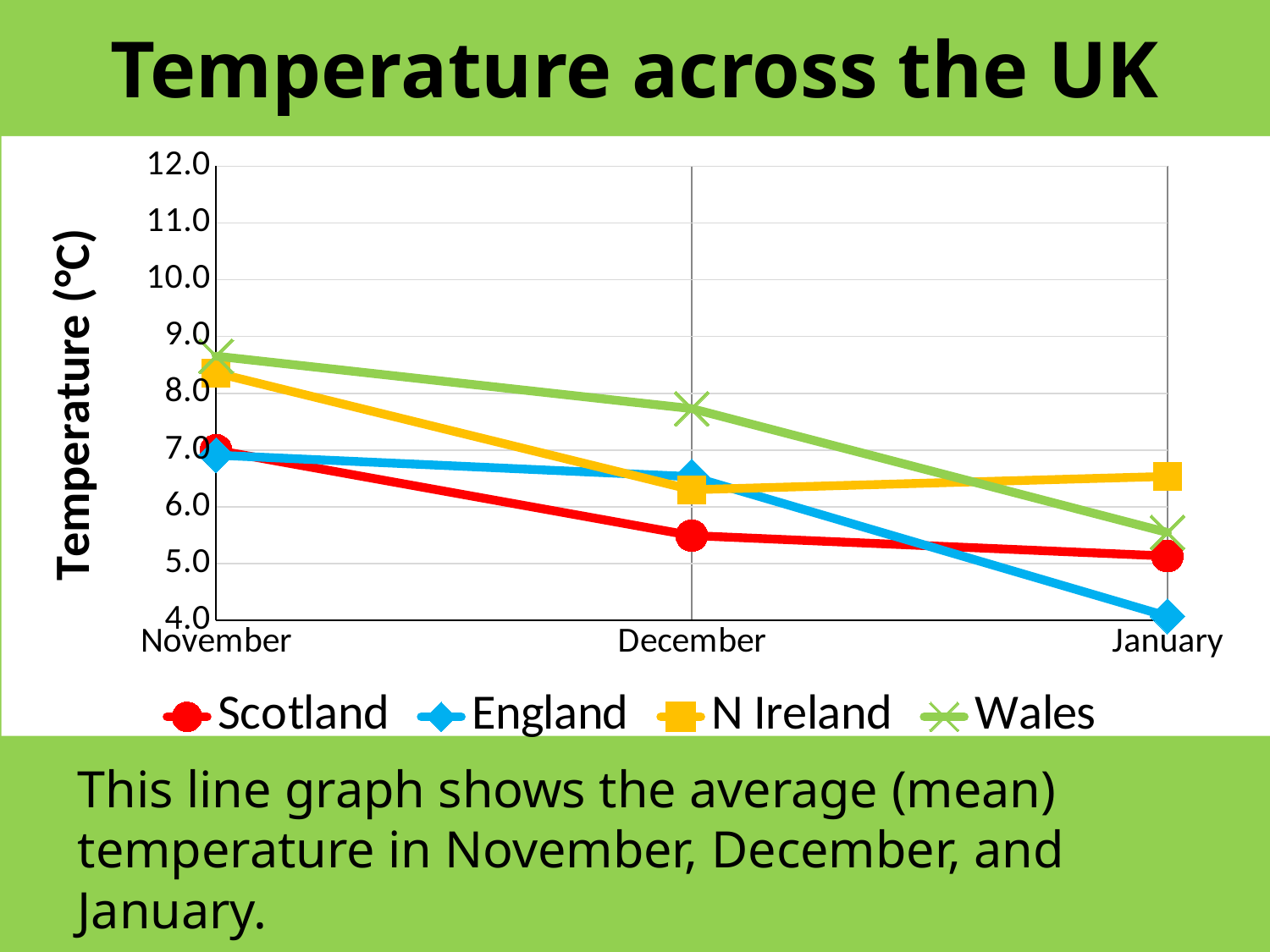
Which country has the highest temperature in January? N Ireland Is the temperature for N Ireland in November greater or less than 8.0? greater Is the temperature for Wales in December greater or less than 7.0? greater Which country has the lowest temperature in January? England How many series does the legend list? 4 Does the temperature for Scotland rise or fall from November to January? fall Which country has the highest temperature in December? Wales How many months are plotted along the x axis? 3 In November, which is higher: the temperature for Wales or for Scotland? Wales Which country has the lowest temperature in December? Scotland Is the temperature for England in January greater or less than 5.0? less What kind of chart is shown on the slide? line chart